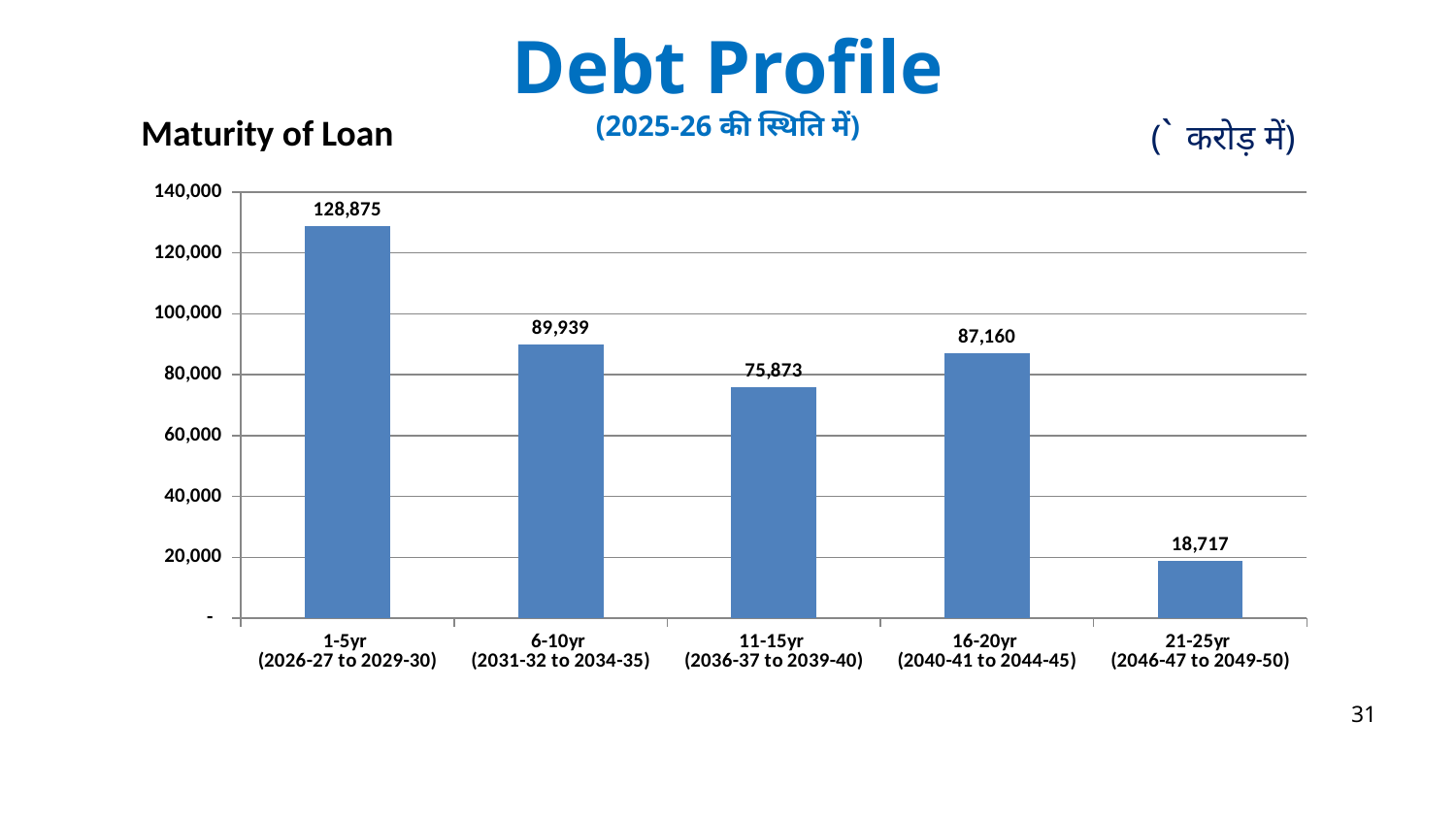
Which maturity bucket has the highest value? 1-5yr (2026-27 to 2029-30) Which maturity bucket has the lowest value? 21-25yr (2046-47 to 2049-50) What kind of chart is shown on the slide? bar chart How many maturity buckets are shown in the chart? 5 What is the difference between the values for the 16-20yr and 21-25yr maturity buckets? 68,443 What is the difference between the values for the 1-5yr and 6-10yr maturity buckets? 38,936 What is the label shown at the top left of the chart? Maturity of Loan Which is larger, the value for 6-10yr or the value for 16-20yr? 6-10yr Is the value for the 11-15yr maturity bucket greater or less than 80,000? less What is the value for the 1-5yr (2026-27 to 2029-30) maturity bucket? 128,875 What is the value for the 21-25yr (2046-47 to 2049-50) maturity bucket? 18,717 What is the value for the 11-15yr (2036-37 to 2039-40) maturity bucket? 75,873